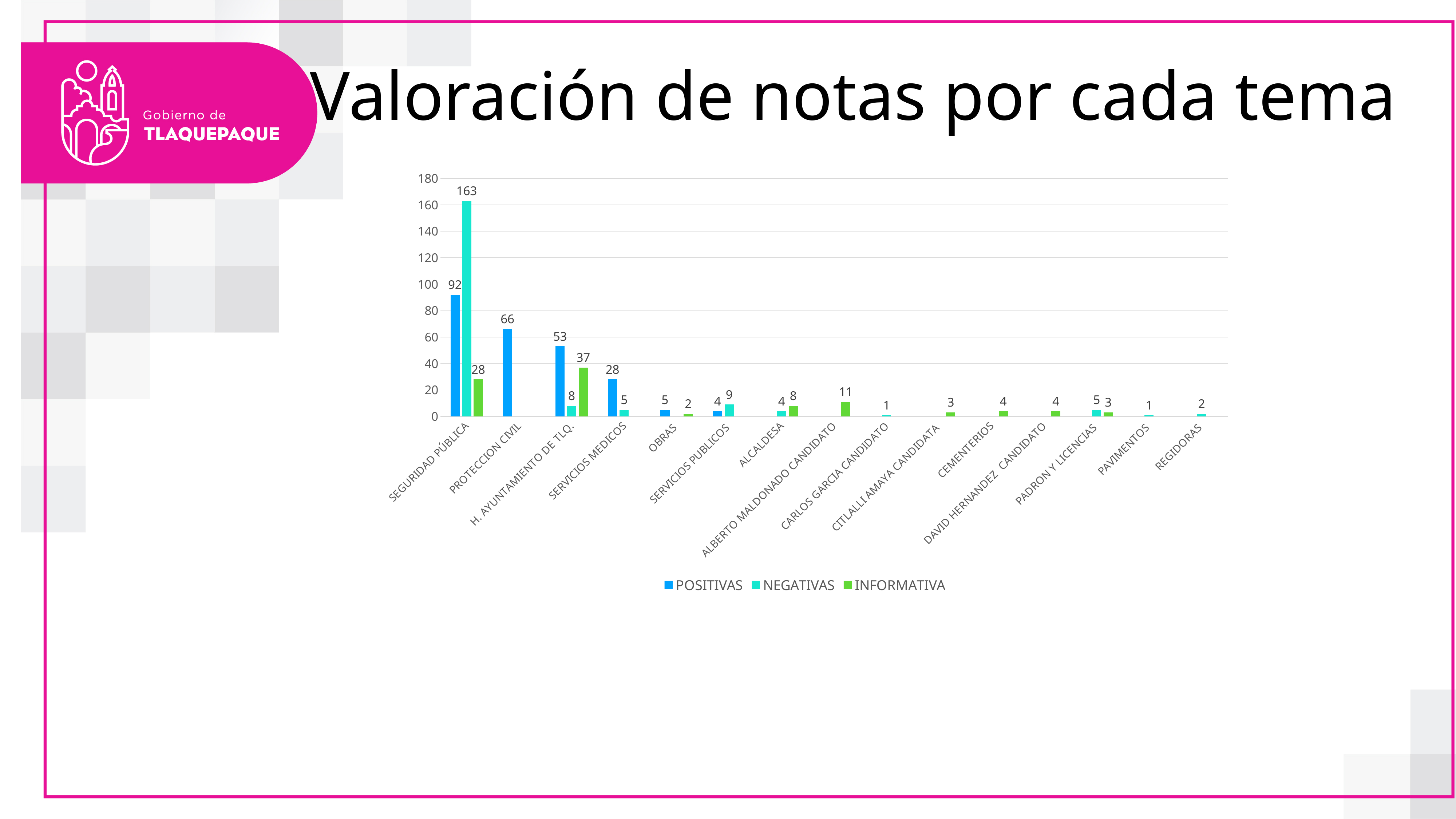
How many categories are shown on the x axis? 15 How many series does the legend list? 3 What is the difference between the NEGATIVAS and POSITIVAS values for SEGURIDAD PÚBLICA? 71 What is the POSITIVAS value for PROTECCION CIVIL? 66 What is the INFORMATIVA value for H. AYUNTAMIENTO DE TLQ.? 37 What is the INFORMATIVA value for ALBERTO MALDONADO CANDIDATO? 11 What is the title of the slide? Valoración de notas por cada tema What kind of chart is shown on the slide? bar chart Is the NEGATIVAS value for SEGURIDAD PÚBLICA greater or less than 140? greater What is the NEGATIVAS value for SEGURIDAD PÚBLICA? 163 Which category has the highest POSITIVAS value? SEGURIDAD PÚBLICA Which is larger for SERVICIOS PUBLICOS, the POSITIVAS value or the NEGATIVAS value? NEGATIVAS